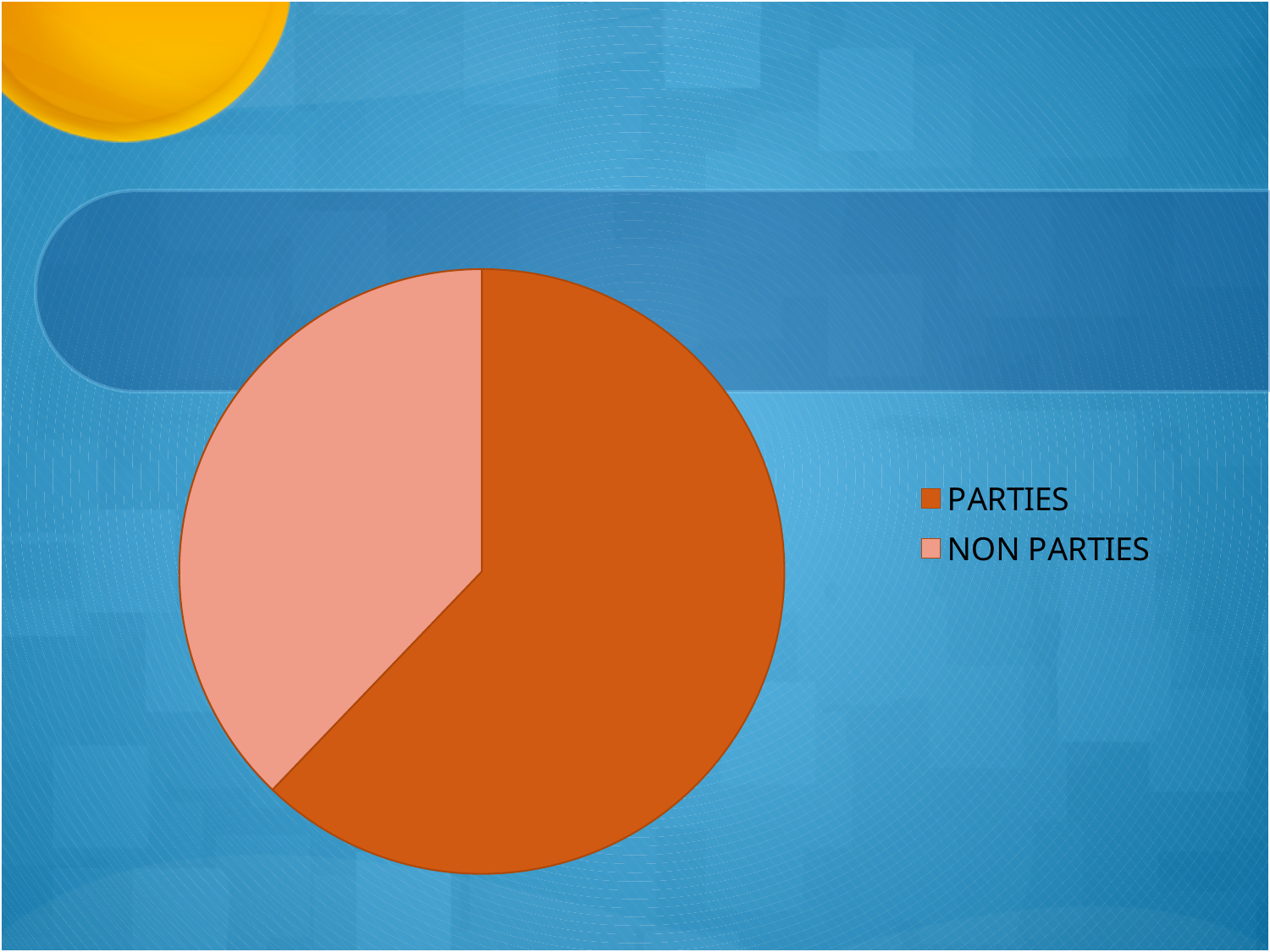
Which slice is larger, PARTIES or NON PARTIES? PARTIES What are the two categories listed in the legend of the pie chart? PARTIES and NON PARTIES How many slices does the pie chart have? 2 Which category is shown in the dark orange colour in the pie chart? PARTIES Which category has the largest slice of the pie chart? PARTIES What kind of chart is shown on the slide? pie chart How many entries does the legend of the pie chart list? 2 Which category has the smallest slice of the pie chart? NON PARTIES